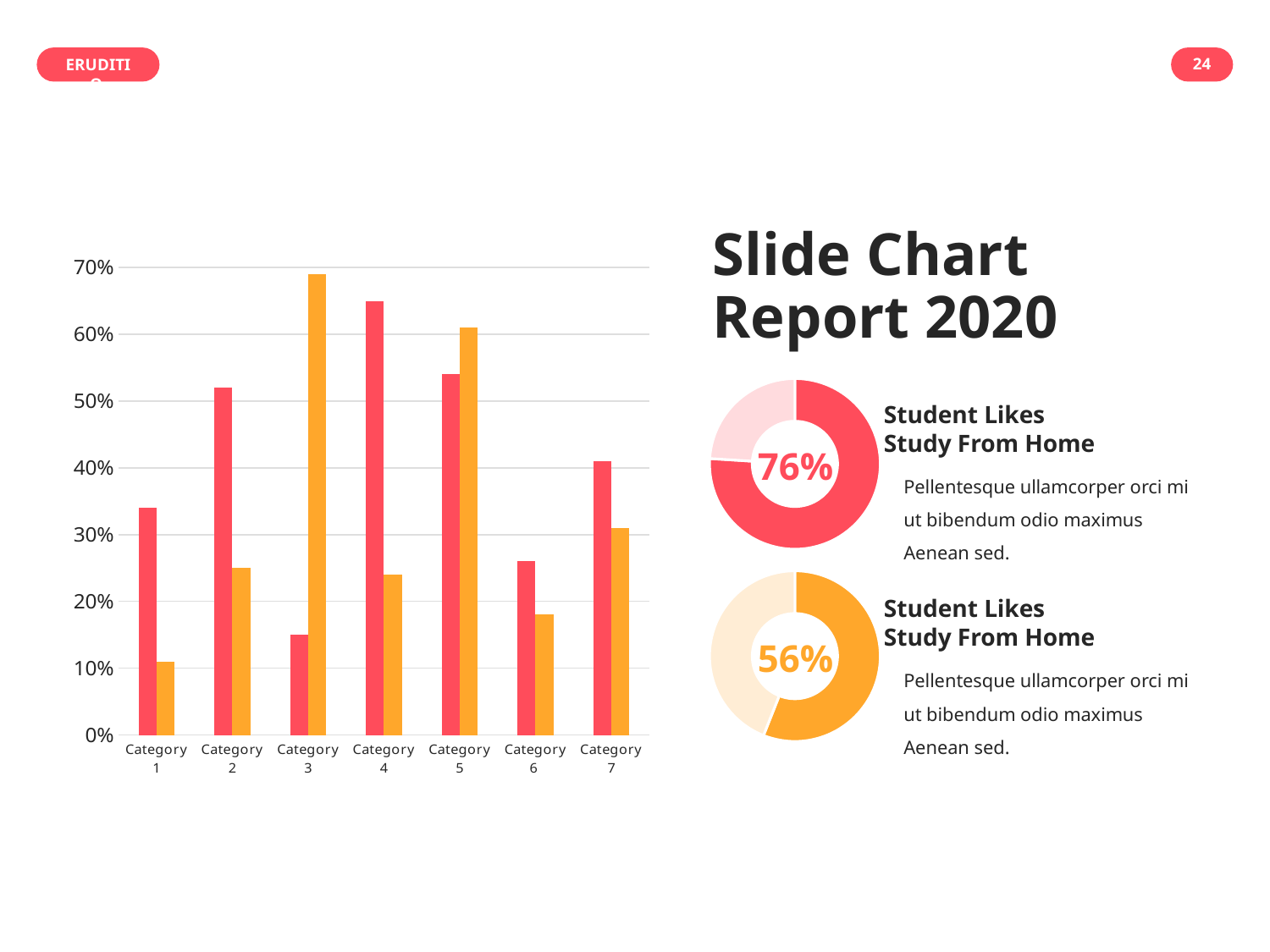
What percentage is shown in the centre of the bottom donut chart on the right of the slide? 56% In the bar chart, is the red bar for Category 1 greater or less than 30%? greater How many categories are shown on the x axis of the bar chart? 7 What kind of chart is the chart on the left of the slide? bar chart In the bar chart, which category has the tallest red bar? Category 4 In the bar chart, is the orange bar for Category 1 greater or less than 20%? less In the bar chart, which category has the shortest red bar? Category 3 What percentage is shown in the centre of the top donut chart on the right of the slide? 76% In the bar chart, for Category 2, which bar is taller, the red one or the orange one? the red one In the bar chart, which category has the shortest orange bar? Category 1 In the bar chart, is the red bar for Category 4 greater or less than 60%? greater In the bar chart, which category has the tallest orange bar? Category 3